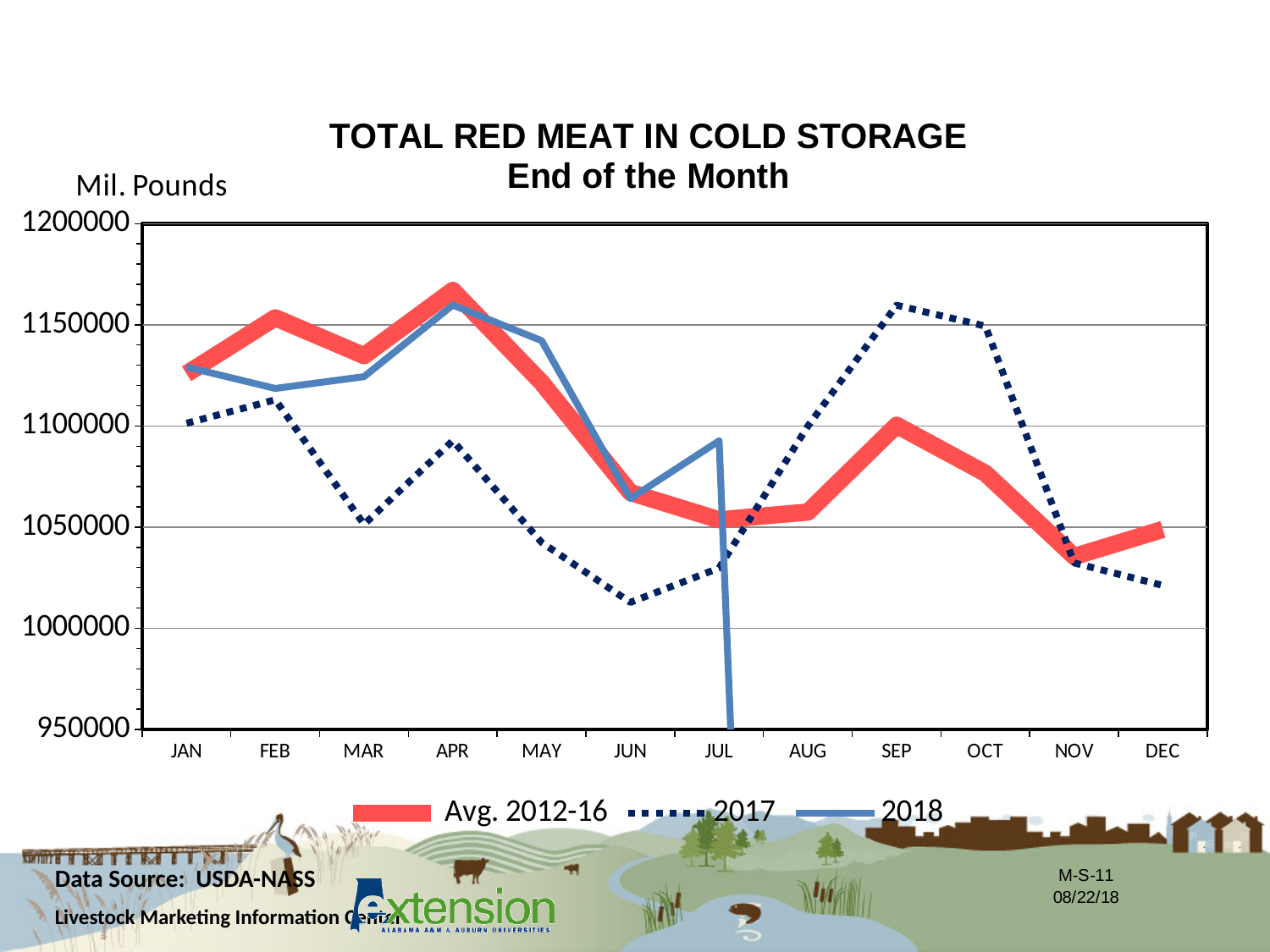
In SEP, which series has the larger value, 2017 or Avg. 2012-16? 2017 In which month does the 2017 series reach its highest value? SEP In which month does the Avg. 2012-16 series reach its highest value? APR In which month does the Avg. 2012-16 series reach its lowest value? NOV In which month does the 2017 series reach its lowest value? JUN What unit label is shown above the y axis? Mil. Pounds How many months are shown along the x axis? 12 Is the 2017 value for JUN greater or less than 1050000? less Does the 2017 series rise or fall from SEP to DEC? fall Is the Avg. 2012-16 value for APR greater or less than 1150000? greater How many series does the legend list? 3 What kind of chart is shown on the slide? line chart